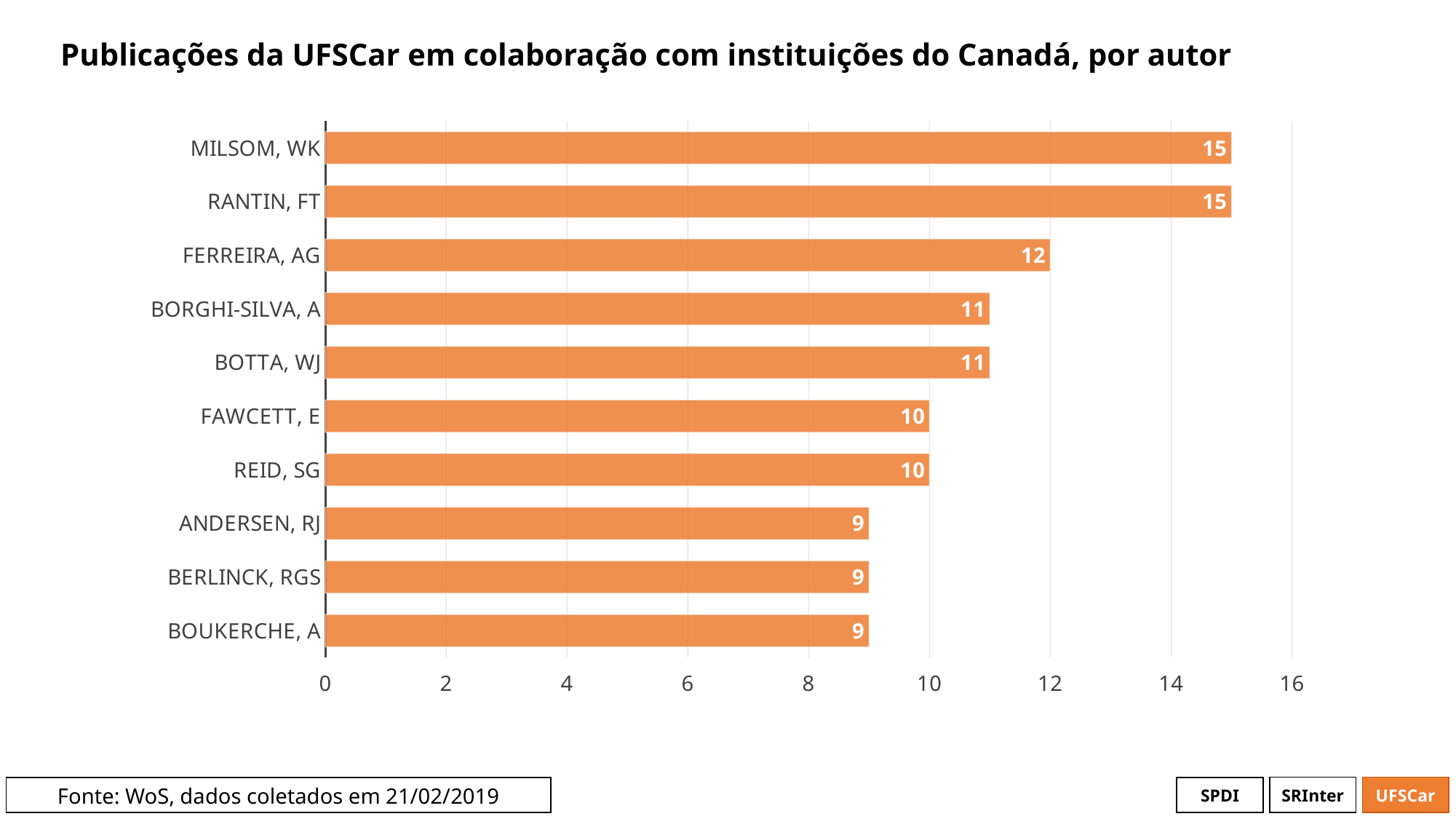
What is the title of the chart? Publicações da UFSCar em colaboração com instituições do Canadá, por autor What is the data source stated on the slide? WoS, dados coletados em 21/02/2019 What is the value for BOUKERCHE, A? 9 Which is larger, the value for FAWCETT, E or the value for BERLINCK, RGS? FAWCETT, E What is the value for BORGHI-SILVA, A? 11 How many authors are shown in the chart? 10 How many publications are shown for FERREIRA, AG? 12 What is the difference between the values for MILSOM, WK and FERREIRA, AG? 3 Which authors have the highest number of publications? MILSOM, WK and RANTIN, FT What kind of chart is shown on the slide? Bar chart What is the value for REID, SG? 10 What is the difference between the values for BOTTA, WJ and ANDERSEN, RJ? 2